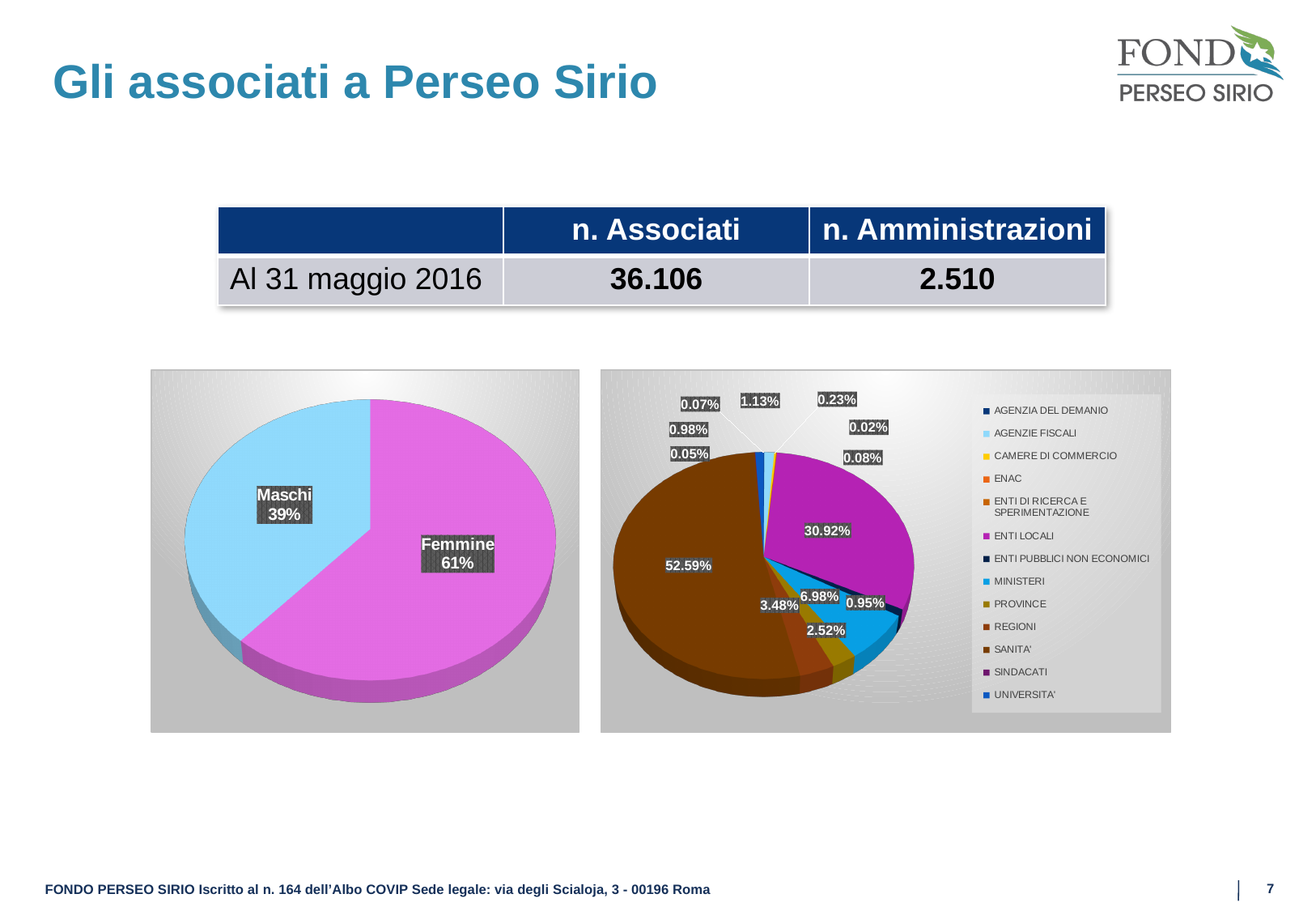
In the right pie chart, what percentage is shown for ENTI LOCALI? 30.92% What type of chart is the chart on the left? Pie chart In the left pie chart, what percentage is shown for Femmine? 61% How many slices does the left pie chart have? 2 In the right pie chart, which category has the largest slice? SANITA' In the right pie chart, what is the smallest percentage label shown? 0.02% In the left pie chart, what is the difference in percentage points between Femmine and Maschi? 22 In the left pie chart, which category has the larger share? Femmine How many entries does the legend of the right pie chart list? 13 In the left pie chart, what percentage is shown for Maschi? 39% In the left pie chart, which category has the smaller share? Maschi In the right pie chart, what is the largest percentage shown on any slice? 52.59%